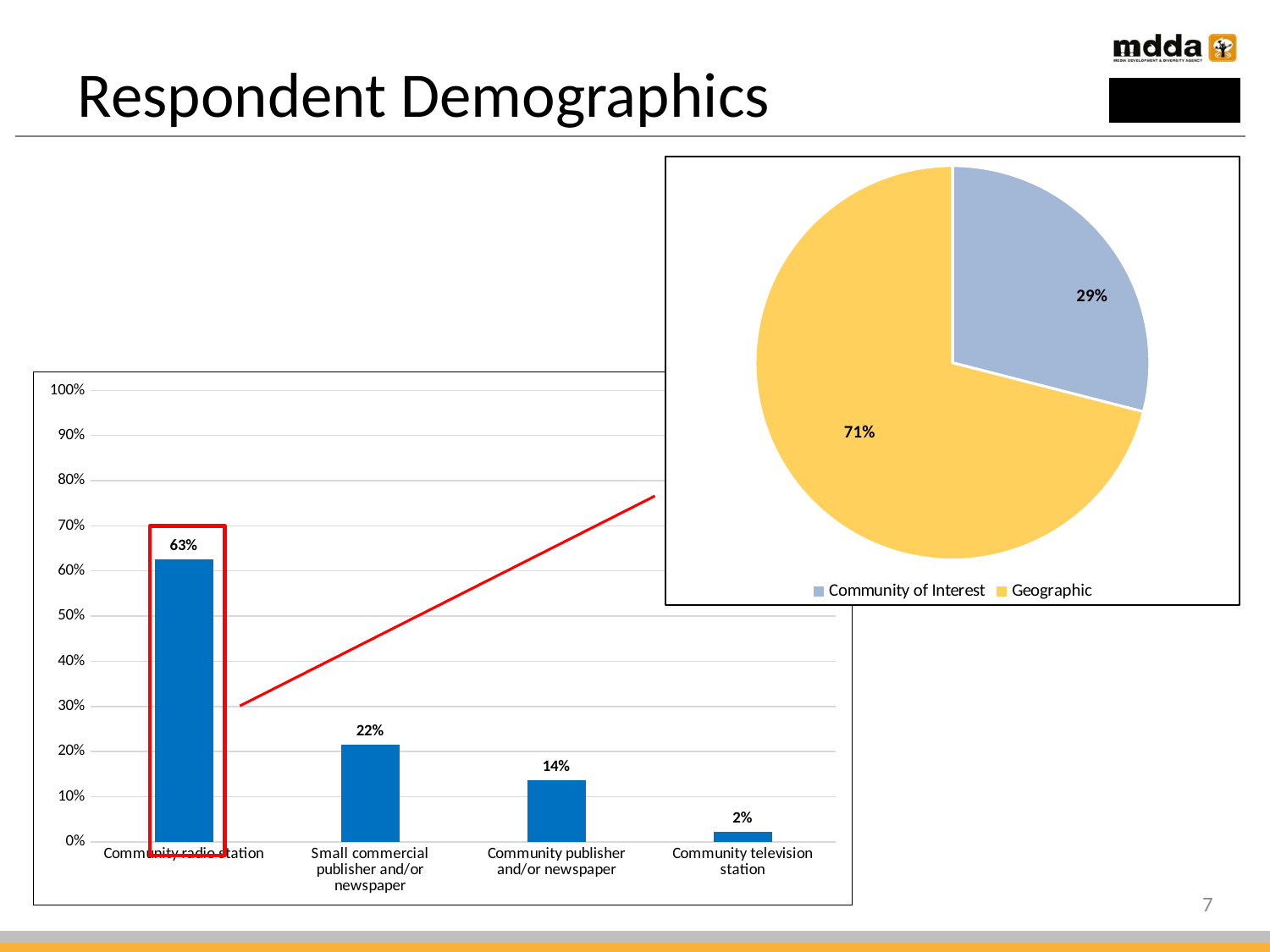
In the bar chart on the left, what is the value for Small commercial publisher and/or newspaper? 22% In the bar chart on the left, how many categories are shown? 4 In the bar chart on the left, which category has the highest value? Community radio station In the bar chart on the left, which is larger: Small commercial publisher and/or newspaper or Community publisher and/or newspaper? Small commercial publisher and/or newspaper In the pie chart on the right, how many entries does the legend list? 2 In the bar chart on the left, what is the value for Community radio station? 63% In the pie chart on the right, what share does Geographic have? 71% In the bar chart on the left, what is the value for Community television station? 2% In the bar chart on the left, what is the difference between Community radio station and Community publisher and/or newspaper? 49% In the pie chart on the right, what share does Community of Interest have? 29% In the bar chart on the left, which category has the lowest value? Community television station What kind of chart is the chart on the left of the slide? Bar chart